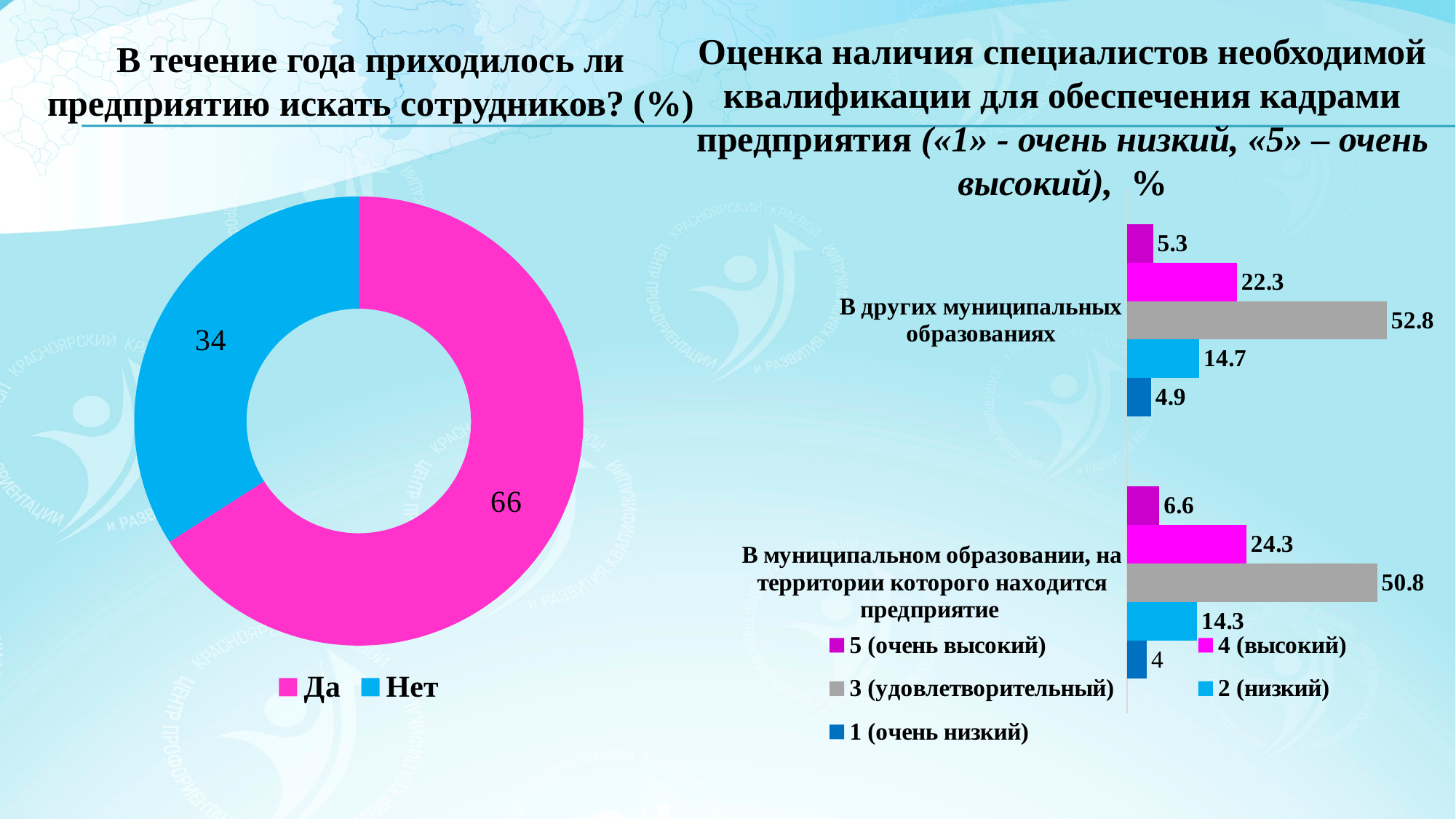
In the right chart 'Оценка наличия специалистов необходимой квалификации...', what is the value for '1 (очень низкий)' in 'В других муниципальных образованиях'? 4.9 In the right chart 'Оценка наличия специалистов необходимой квалификации...', what is the value for '4 (высокий)' in 'В муниципальном образовании, на территории которого находится предприятие'? 24.3 In the right chart 'Оценка наличия специалистов необходимой квалификации...', which is larger: '5 (очень высокий)' for 'В других муниципальных образованиях' or for 'В муниципальном образовании, на территории которого находится предприятие'? В муниципальном образовании, на территории которого находится предприятие What kind of chart is the left chart 'В течение года приходилось ли предприятию искать сотрудников? (%)'? Donut (pie) chart In the left chart 'В течение года приходилось ли предприятию искать сотрудников? (%)', what is the value for 'Нет'? 34 In the left chart 'В течение года приходилось ли предприятию искать сотрудников? (%)', what is the difference between 'Да' and 'Нет'? 32 In the right chart 'Оценка наличия специалистов необходимой квалификации...', what is the difference between '3 (удовлетворительный)' for 'В других муниципальных образованиях' and for 'В муниципальном образовании, на территории которого находится предприятие'? 2 In the left chart 'В течение года приходилось ли предприятию искать сотрудников? (%)', which answer has the larger share? Да In the right chart 'Оценка наличия специалистов необходимой квалификации...', how many series does the legend list? 5 In the left chart 'В течение года приходилось ли предприятию искать сотрудников? (%)', what is the value for 'Да'? 66 In the right chart 'Оценка наличия специалистов необходимой квалификации...', which rating has the lowest value for 'В муниципальном образовании, на территории которого находится предприятие'? 1 (очень низкий) In the right chart 'Оценка наличия специалистов необходимой квалификации...', what is the value for '3 (удовлетворительный)' in 'В других муниципальных образованиях'? 52.8